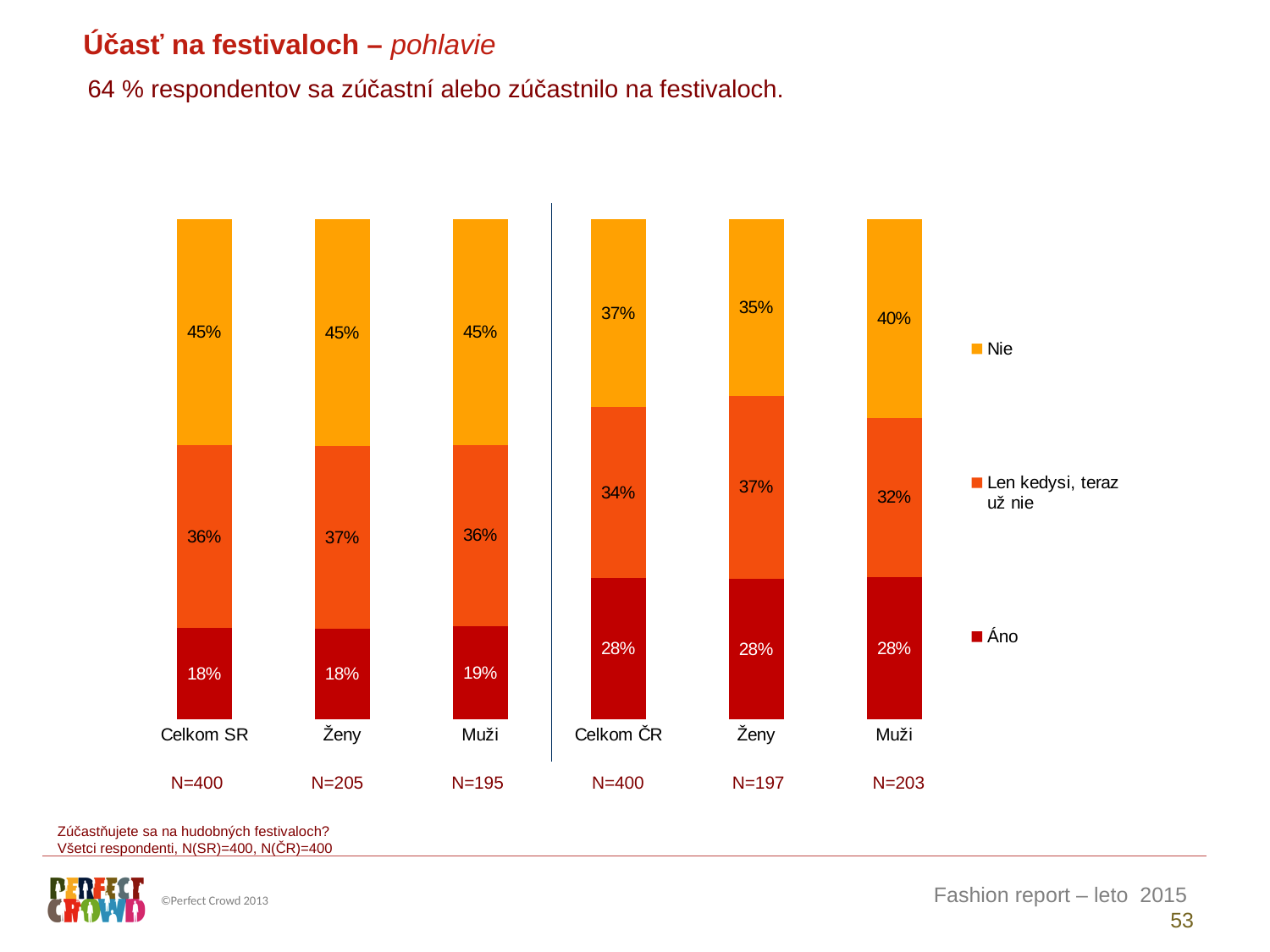
What kind of chart is shown on the slide? Stacked bar chart What is the value of the 'Áno' segment for Celkom SR? 18% Which category has the highest 'Nie' value? Celkom SR, Ženy and Muži in the SR group (45% each) What is the value of the 'Nie' segment for Muži in the ČR group? 40% Which category has the lowest 'Len kedysi, teraz už nie' value? Muži (ČR group) Which is larger: the 'Nie' value for Celkom SR or the 'Nie' value for Celkom ČR? Celkom SR How many series does the legend list? 3 How many bars (categories) are plotted in the chart? 6 What is the total of the 'Áno' and 'Len kedysi, teraz už nie' segments for Celkom ČR? 62% What is the value of the 'Len kedysi, teraz už nie' segment for Ženy in the ČR group? 37% What is the sample size (N) shown for Muži in the SR group? N=195 What is the difference between the 'Áno' value for Celkom ČR and the 'Áno' value for Celkom SR? 10 percentage points